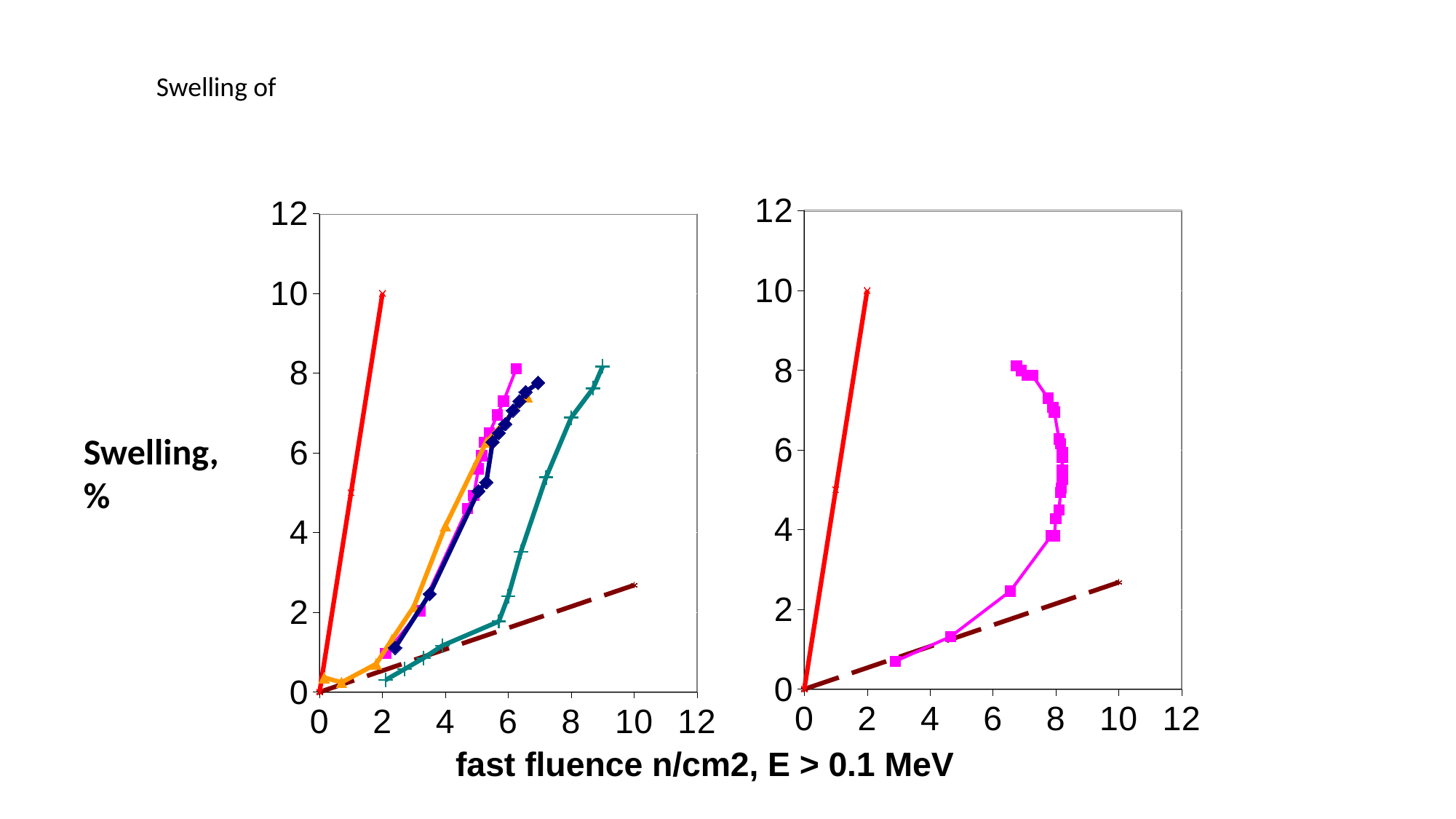
What is the label of the x axis shared by the two charts? fast fluence n/cm2, E > 0.1 MeV On the right chart, how many lines are plotted? 3 On the left chart, is the value of the teal line with cross markers at a fast fluence of 9 greater or less than 6? greater On the left chart, which line reaches the highest swelling value? the solid red line What kind of chart is shown on the left of the slide? line chart On the left chart, how many lines are plotted? 6 What is the label of the y axis on the left chart? Swelling, % On the left chart, at a fast fluence of 6, which line has the larger swelling value: the magenta line with square markers or the teal line with cross markers? magenta line with square markers On the right chart, is the highest value reached by the magenta line with square markers greater or less than 6? greater On the left chart, is the value of the dashed line at a fast fluence of 10 greater or less than 4? less On the right chart, does the dashed line rise or fall as fast fluence increases? rise